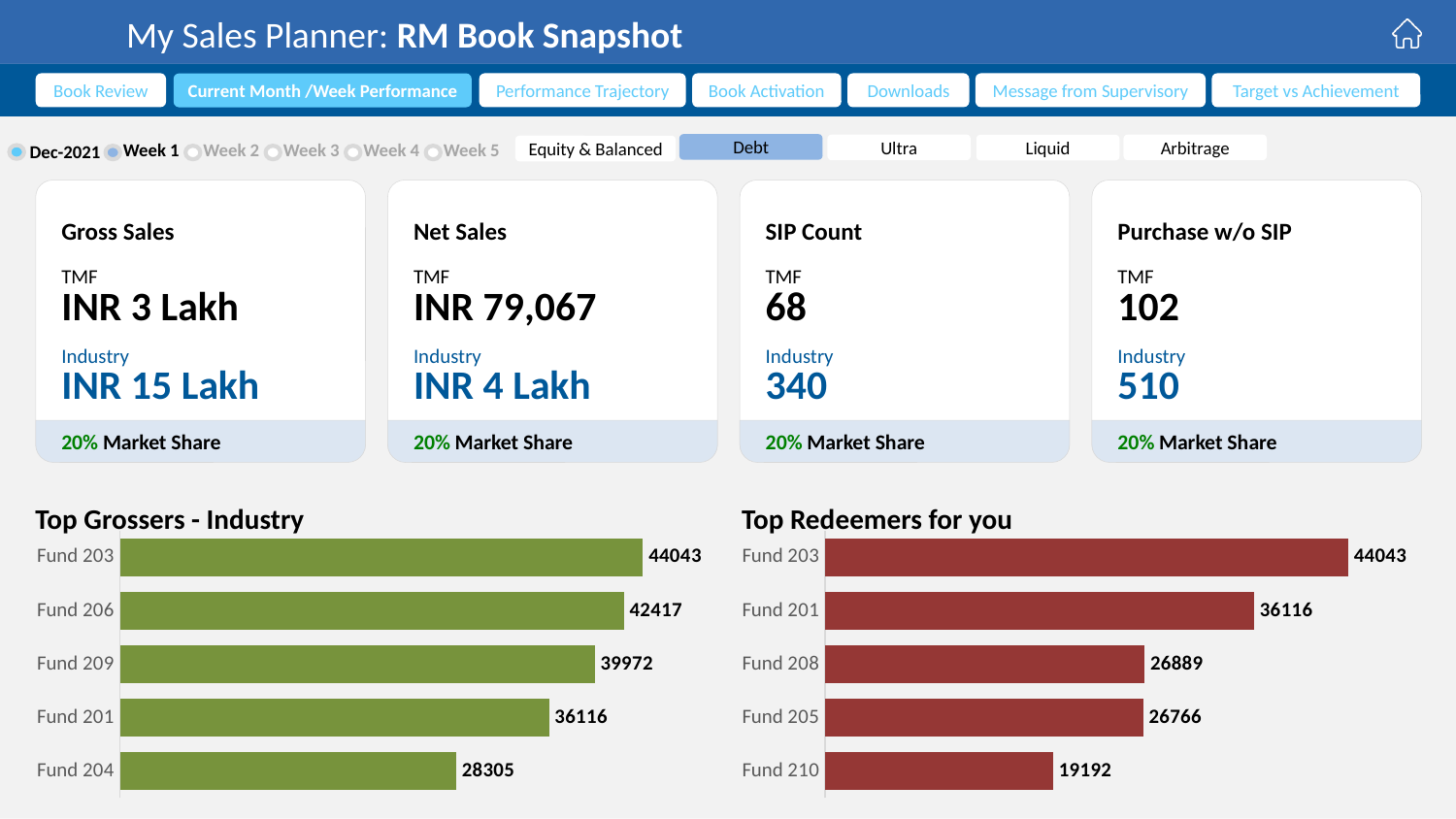
In the Top Grossers - Industry chart, how many funds are shown? 5 In the Top Redeemers for you chart, which is larger, Fund 201 or Fund 208? Fund 201 In the Top Grossers - Industry chart, what is the value for Fund 206? 42417 What colour are the bars in the Top Grossers - Industry chart? Green In the Top Grossers - Industry chart, what is the difference between Fund 203 and Fund 201? 7927 What type of chart is the Top Redeemers for you chart? Bar chart In the Top Grossers - Industry chart, which fund has the highest value? Fund 203 In the Top Redeemers for you chart, what is the value for Fund 208? 26889 In the Top Redeemers for you chart, what is the difference between Fund 203 and Fund 201? 7927 In the Top Redeemers for you chart, what is the value for Fund 210? 19192 In the Top Grossers - Industry chart, what is the value for Fund 204? 28305 In the Top Redeemers for you chart, which fund has the lowest value? Fund 210